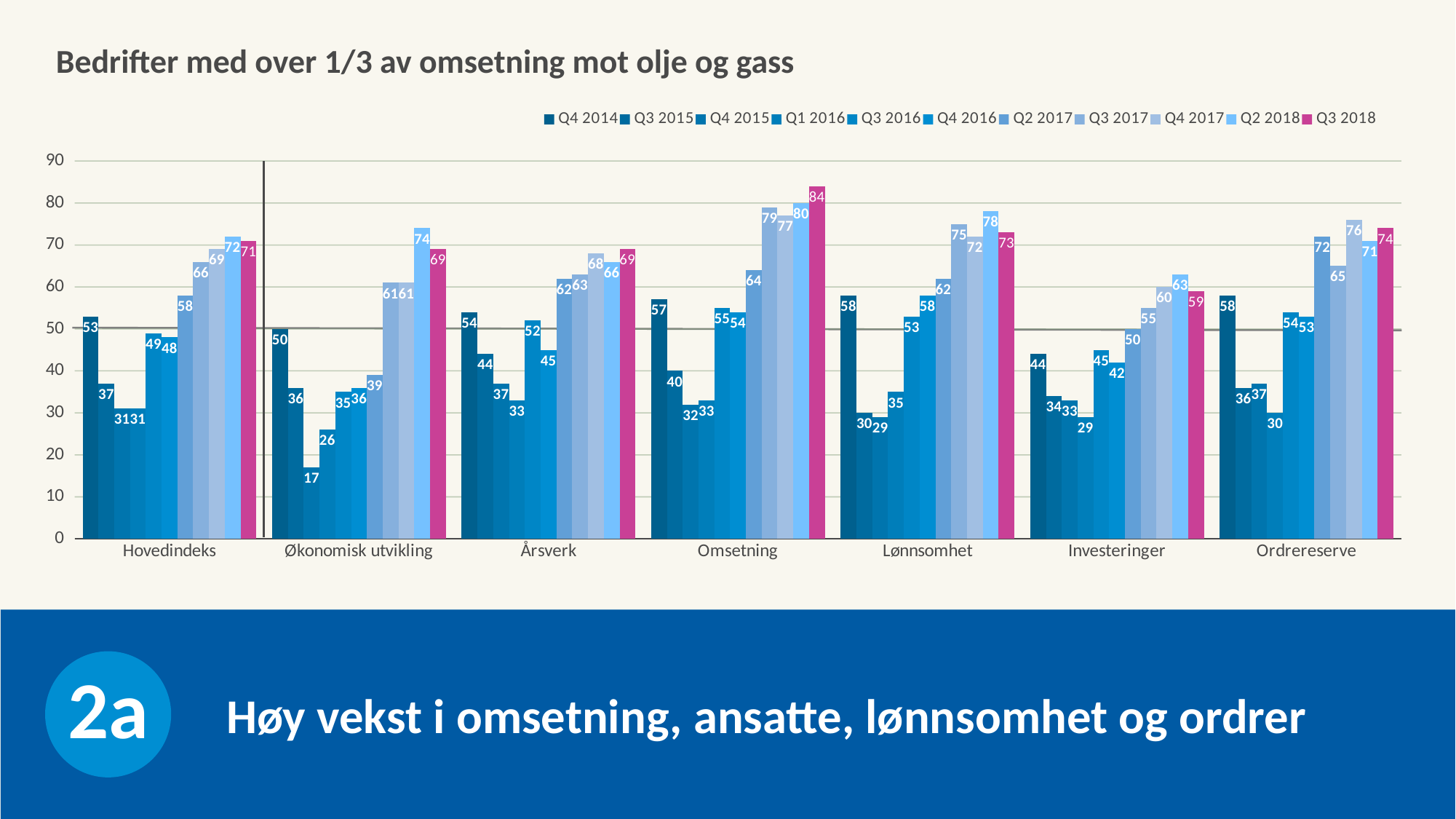
Which is larger, the Q3 2018 value for Lønnsomhet or for Investeringer? Lønnsomhet Which category has the highest Q3 2018 value? Omsetning What is the Q2 2018 value for Økonomisk utvikling? 74 Which category has the lowest Q3 2018 value? Investeringer What is the title of the chart? Bedrifter med over 1/3 av omsetning mot olje og gass What is the Q4 2014 value for Hovedindeks? 53 What is the lowest value shown anywhere in the chart, and for which category? 17, Økonomisk utvikling How many series does the legend list? 11 How many categories are shown on the x axis? 7 What type of chart is shown on the slide? bar chart What is the Q3 2018 value for Omsetning? 84 What is the difference between the Q3 2018 values for Omsetning and Hovedindeks? 13